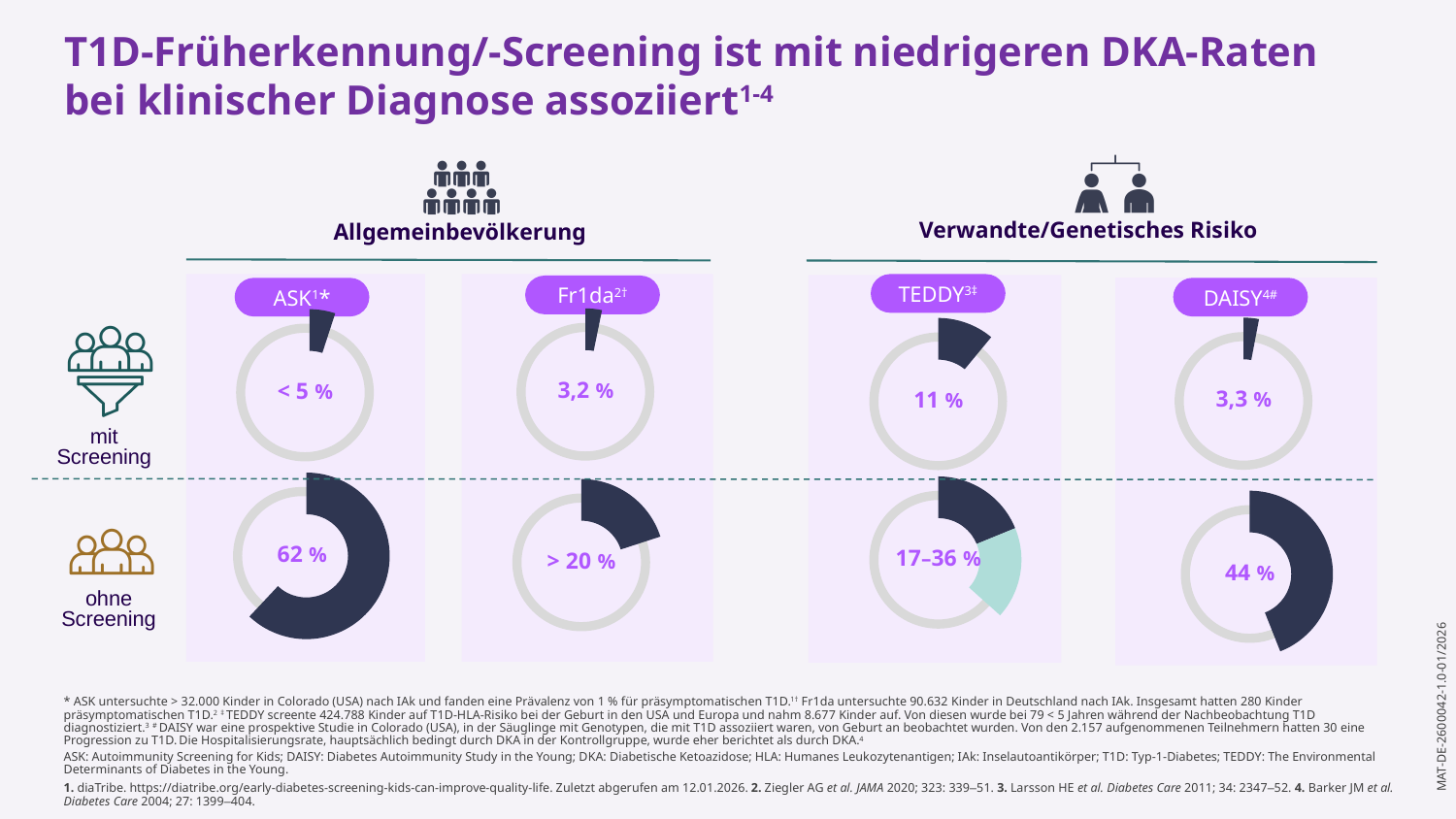
What type of chart is used to display the DKA rates on this slide? Donut (pie) chart In the DAISY chart, what value is shown for 'ohne Screening'? 44 % In the DAISY charts, which is larger: the 'mit Screening' value or the 'ohne Screening' value? ohne Screening In the ASK chart, what DKA rate is shown for the 'ohne Screening' row? 62 % In the ASK chart, what DKA rate is shown for the 'mit Screening' row? < 5 % In the DAISY chart, what value is shown for 'mit Screening'? 3,3 % Among the 'mit Screening' charts with exact values (Fr1da, TEDDY, DAISY), which study shows the highest DKA rate? TEDDY In the Fr1da chart, what value is shown for 'mit Screening'? 3,2 % In the TEDDY chart, what range is shown for 'ohne Screening'? 17–36 % In the TEDDY chart, what value is shown for 'mit Screening'? 11 % In the Fr1da chart, what value is shown for 'ohne Screening'? > 20 % What is the difference between the DAISY 'ohne Screening' value and the DAISY 'mit Screening' value? 40,7 %